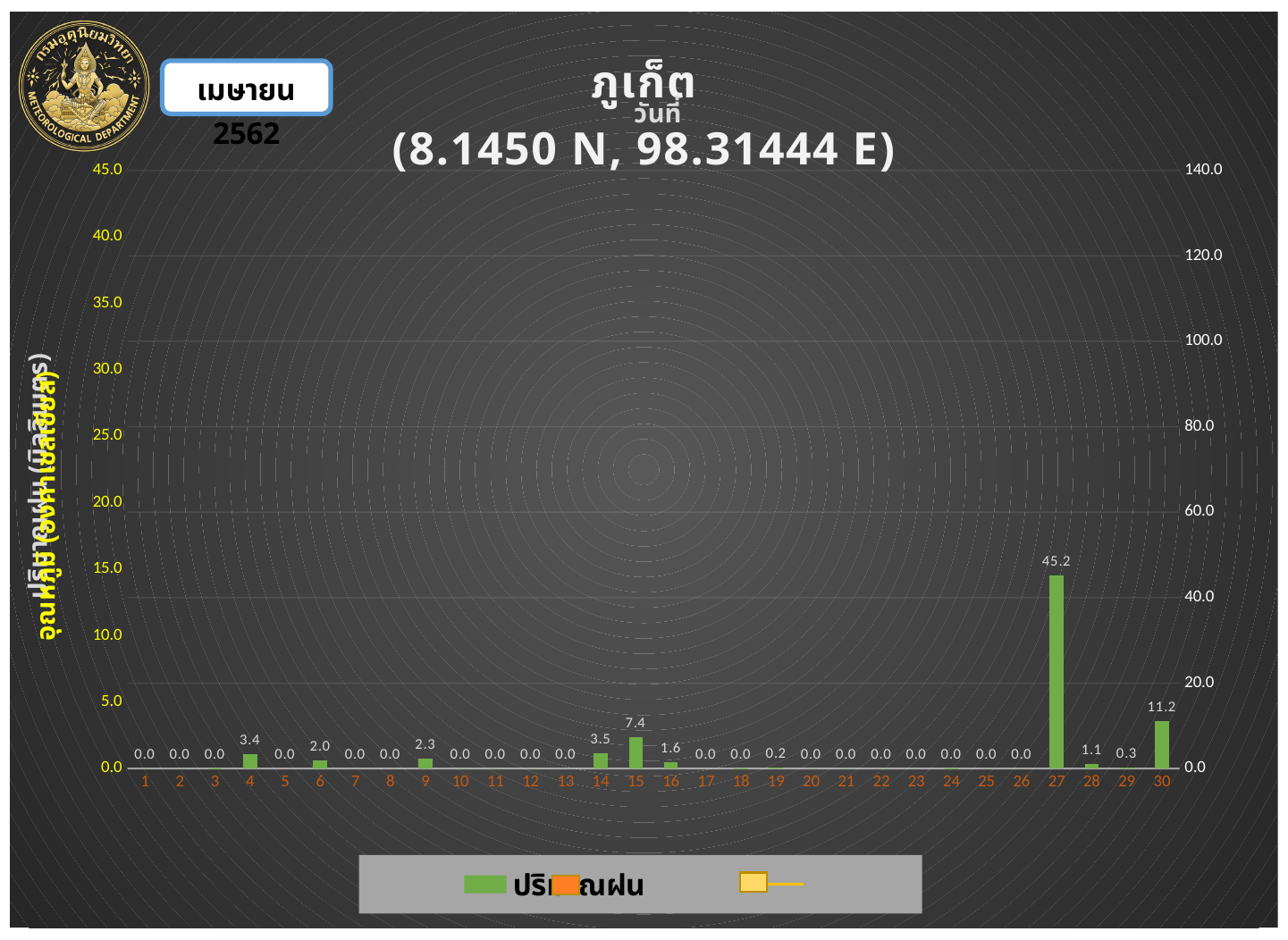
What is the rainfall value shown for day 4? 3.4 How many days are shown on the x axis? 30 What is the rainfall value shown for day 30? 11.2 Which is larger, the rainfall value for day 9 or for day 6? day 9 What is the rainfall value shown for day 15? 7.4 What is the rainfall value shown for day 19? 0.2 What is the difference between the rainfall values for day 27 and day 30? 34.0 What kind of chart is shown on the slide? bar chart Is the rainfall value for day 27 greater or less than 40.0 on the right axis? greater What is the difference between the rainfall values for day 15 and day 14? 3.9 What is the rainfall value shown for day 27? 45.2 Which day has the highest rainfall value? 27